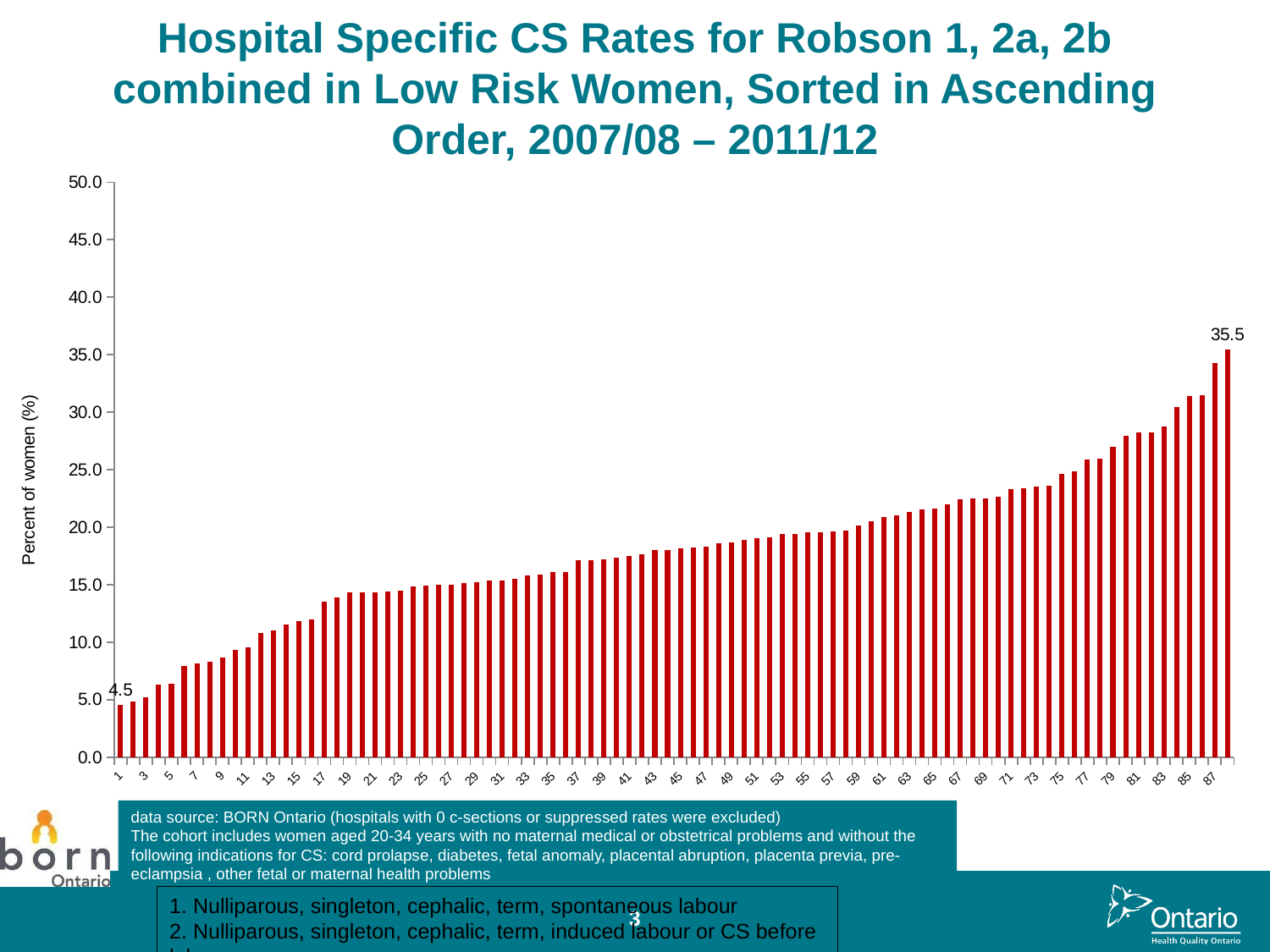
What is the label on the vertical axis of the chart? Percent of women (%) What is the difference between the highest (35.5) and lowest (4.5) CS rates shown? 31.0 What is the CS rate for the hospital with the lowest value (hospital 1)? 4.5 What is the highest hospital-specific CS rate shown on the chart? 35.5 Do the CS rates rise or fall from left to right along the x axis? rise What is the lowest hospital-specific CS rate shown on the chart? 4.5 Is the value for hospital 45 greater or less than 15.0? greater Is the value for hospital 9 greater or less than 10.0? less What kind of chart is shown on the slide? bar chart Which hospital has the larger CS rate, hospital 1 or hospital 87? hospital 87 Is the value for hospital 77 greater or less than 25.0? greater